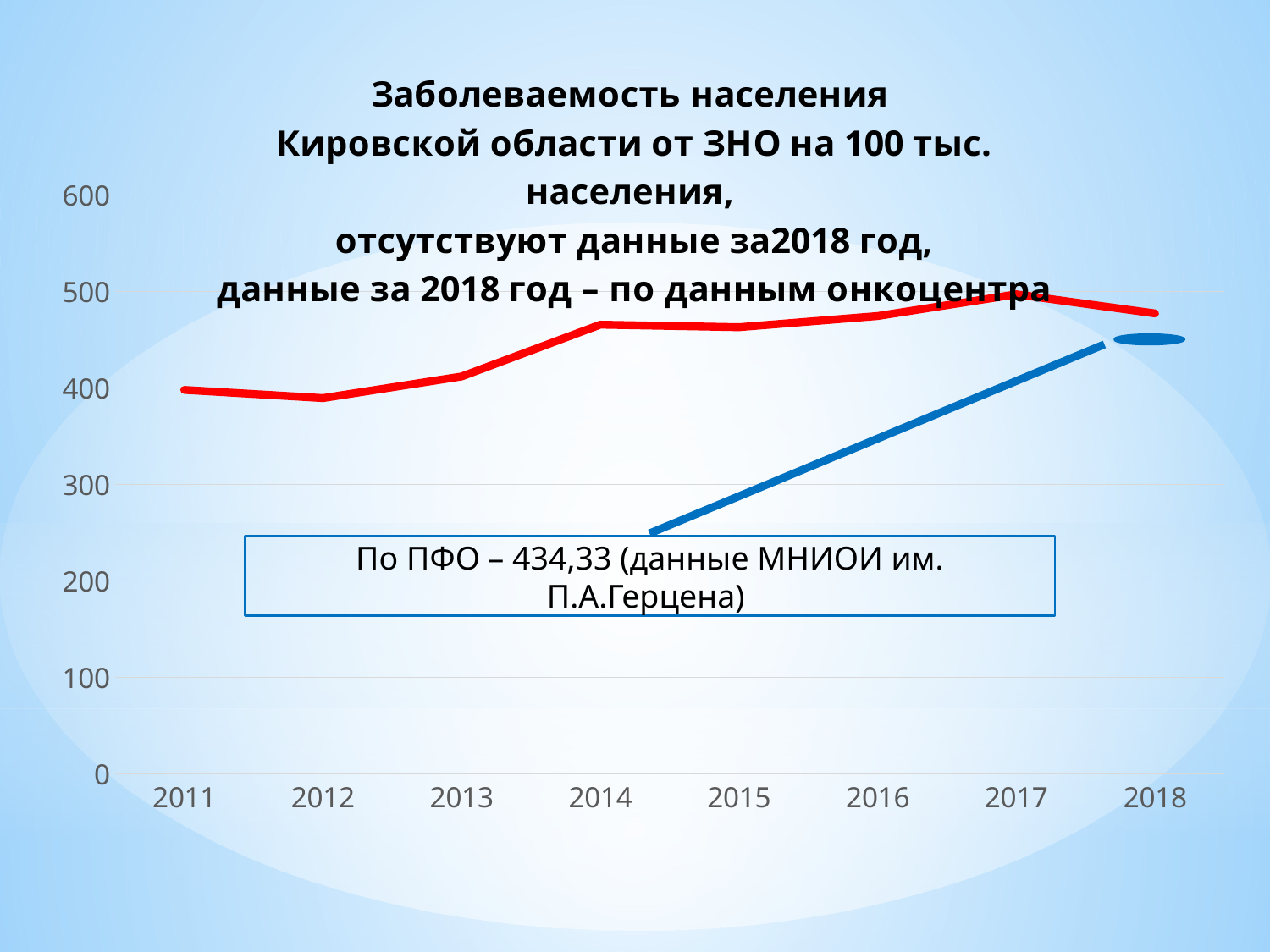
What kind of chart is shown on the slide? line chart Which is larger, the value for 2017 or the value for 2018? 2017 Is the value for 2018 greater or less than 500? less Is the value for 2012 greater or less than 400? less How many years are plotted along the x axis? 8 Which is larger, the value for 2013 or the value for 2014? 2014 What value for the ПФО is given in the text box on the chart? 434,33 Is the value for 2014 greater or less than 400? greater Which year has the lowest value on the chart? 2012 Which year has the highest value on the chart? 2017 Does the line generally rise or fall from 2011 to 2017? rise